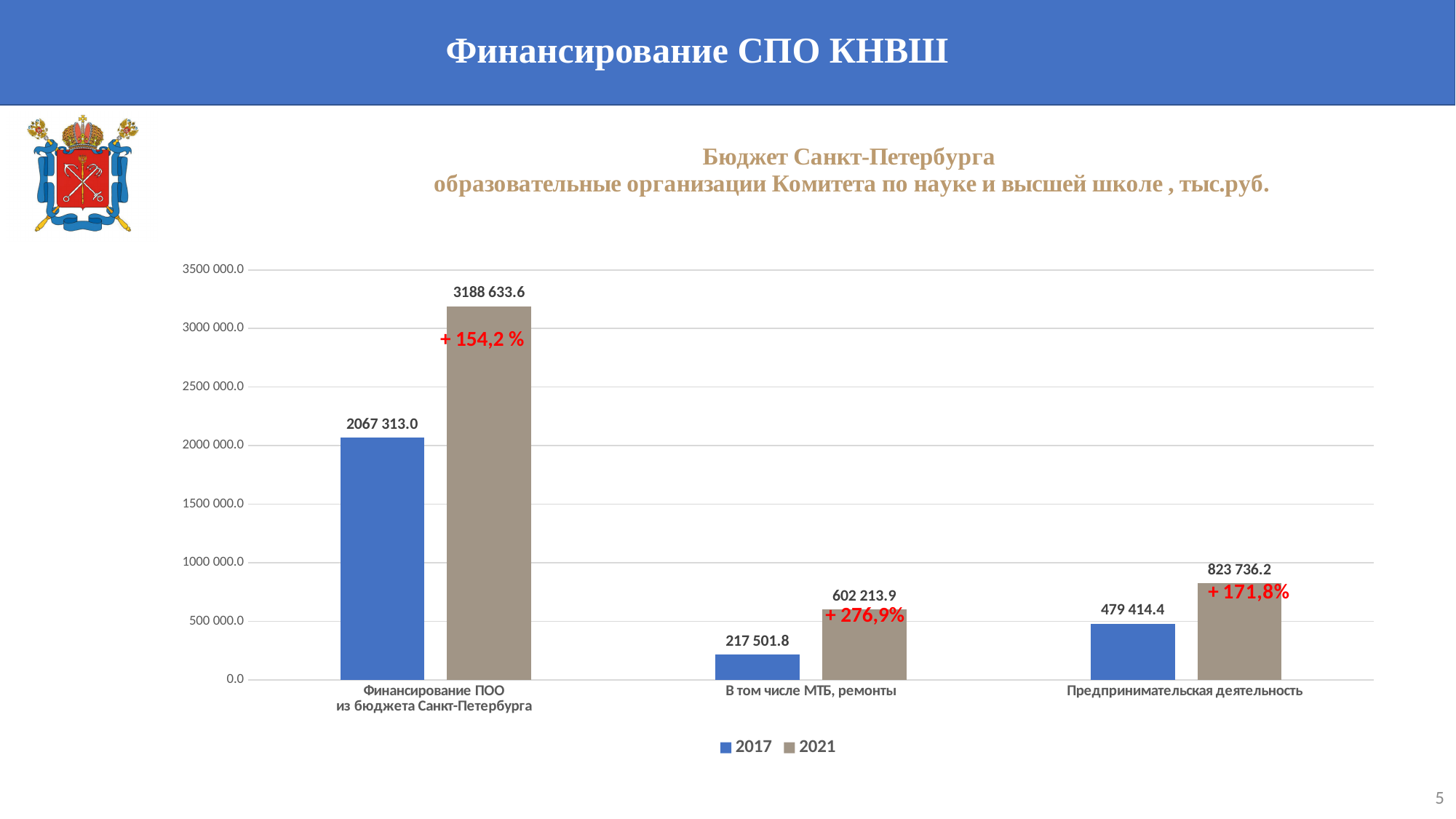
What is the 2021 value for "Финансирование ПОО из бюджета Санкт-Петербурга"? 3188 633.6 What percentage increase is printed in red above the 2021 bar for "В том числе МТБ, ремонты"? + 276,9% How many categories are shown on the x axis? 3 What is the 2021 value for "Предпринимательская деятельность"? 823 736.2 What type of chart is shown on the slide? bar chart Which category has the highest 2021 value? Финансирование ПОО из бюджета Санкт-Петербурга What is the 2017 value for "В том числе МТБ, ремонты"? 217 501.8 Which category has the lowest 2017 value? В том числе МТБ, ремонты What is the difference between the 2021 and 2017 values for "Финансирование ПОО из бюджета Санкт-Петербурга"? 1121 320.6 How many series does the legend list? 2 What is the difference between the 2021 and 2017 values for "Предпринимательская деятельность"? 344 321.8 Which is larger: the 2017 value for "Предпринимательская деятельность" or the 2021 value for "В том числе МТБ, ремонты"? 2021 value for В том числе МТБ, ремонты